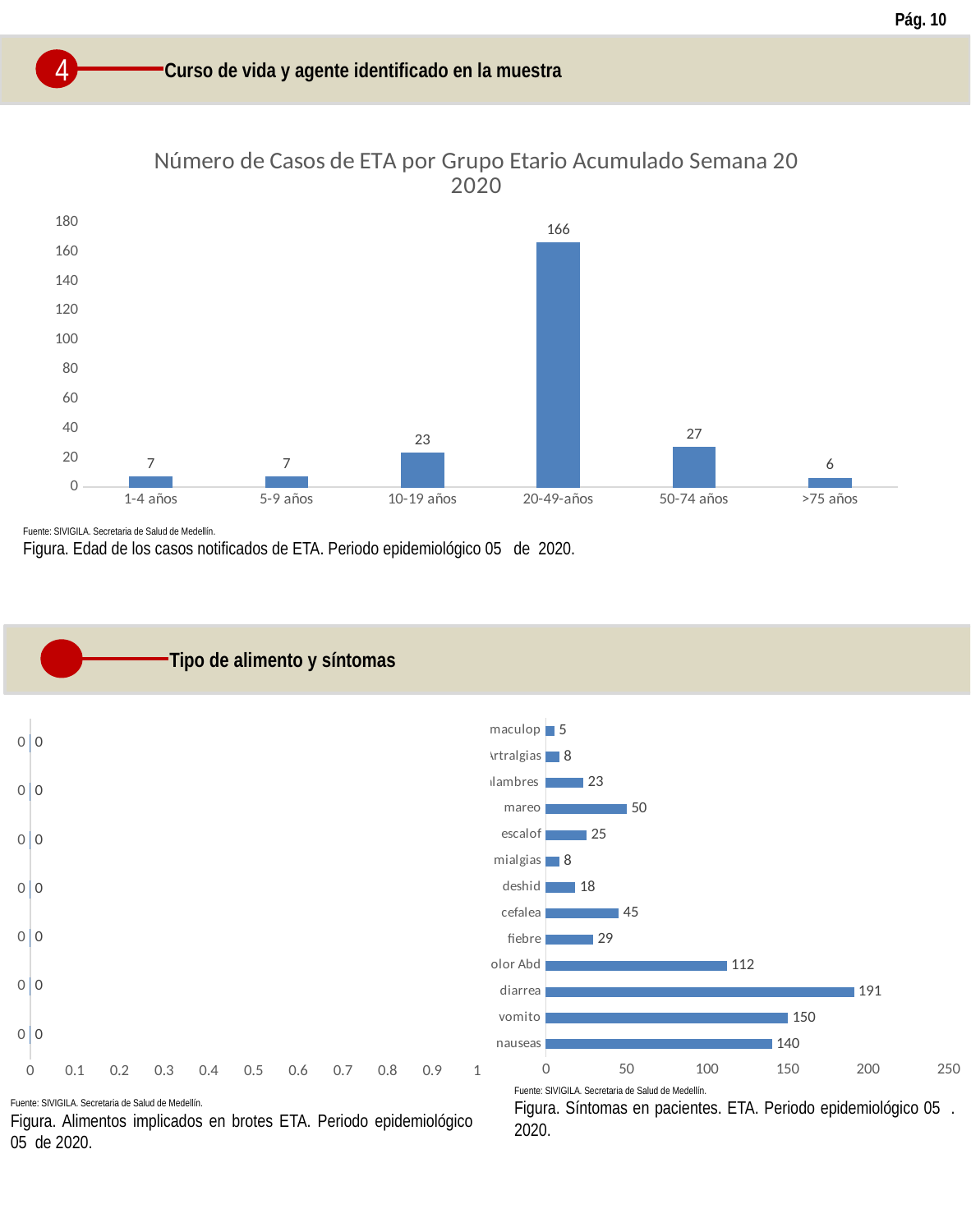
In the symptoms chart at the bottom right of the slide, how many patients reported cefalea? 45 In the chart titled 'Número de Casos de ETA por Grupo Etario Acumulado Semana 20 2020', what is the difference in cases between the 20-49-años group and the 10-19 años group? 143 In the symptoms chart at the bottom right of the slide, which is larger: vomito or nauseas? vomito In the chart titled 'Número de Casos de ETA por Grupo Etario Acumulado Semana 20 2020', which age group has the lowest number of cases? >75 años What type of chart is the one titled 'Número de Casos de ETA por Grupo Etario Acumulado Semana 20 2020'? Bar chart In the symptoms chart at the bottom right of the slide, which symptom has the highest value? diarrea In the chart titled 'Número de Casos de ETA por Grupo Etario Acumulado Semana 20 2020', which age group has the highest number of cases? 20-49-años In the chart titled 'Número de Casos de ETA por Grupo Etario Acumulado Semana 20 2020', how many cases are reported for the 20-49-años group? 166 In the symptoms chart at the bottom right of the slide, how many patients reported diarrea? 191 In the chart titled 'Número de Casos de ETA por Grupo Etario Acumulado Semana 20 2020', how many cases are reported for the 50-74 años group? 27 In the symptoms chart at the bottom right of the slide, what is the difference between the values for mareo and fiebre? 21 In the chart titled 'Número de Casos de ETA por Grupo Etario Acumulado Semana 20 2020', how many age groups are shown? 6